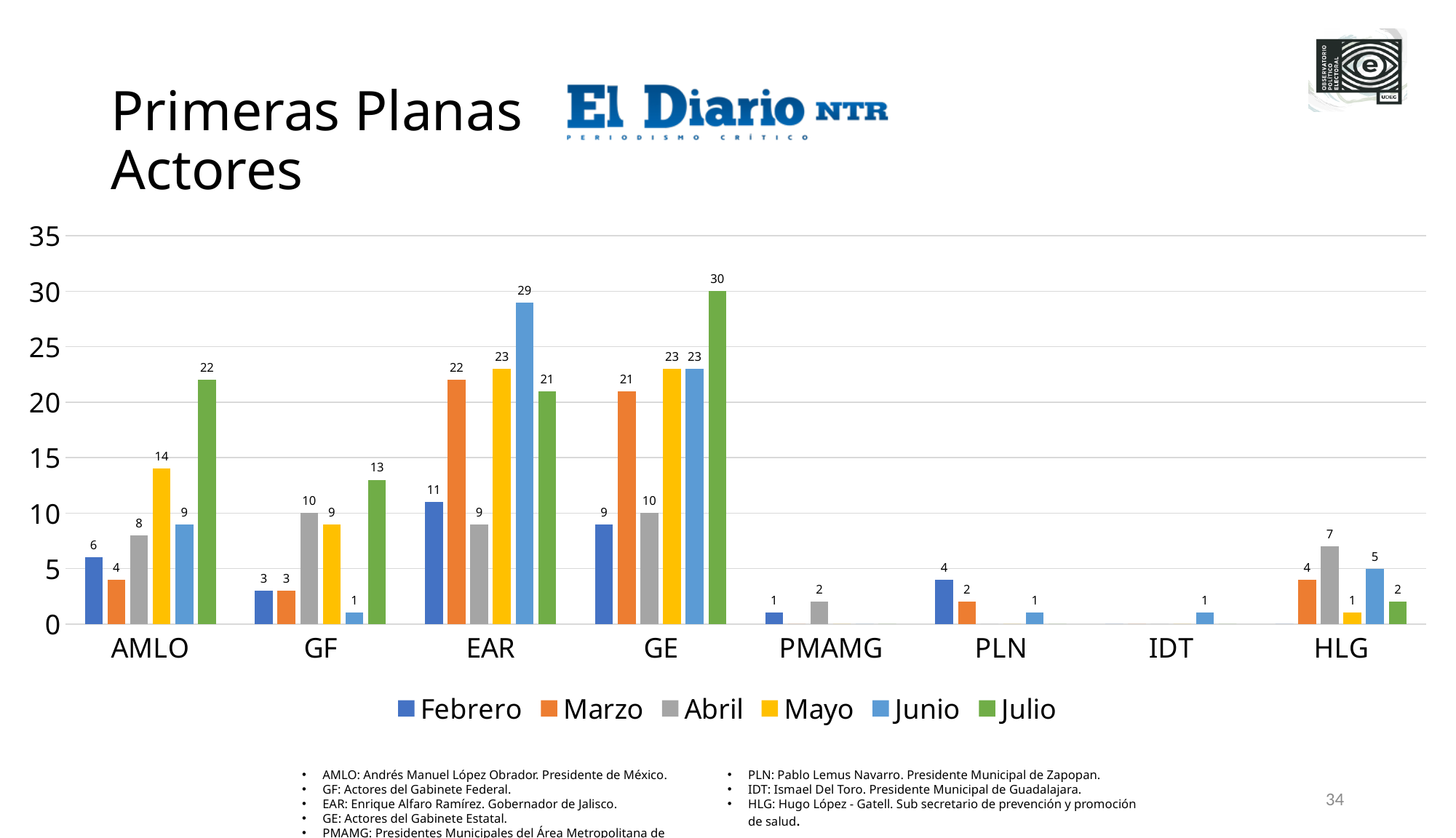
What is the value for Junio for EAR? 29 How many categories are shown on the x axis? 8 What is the value for Abril for HLG? 7 Which is larger for EAR: the Marzo value or the Mayo value? Mayo How many series does the legend list? 6 What kind of chart is shown on the slide? Bar chart Which month has the lowest value for GF? Junio What is the value for Mayo for AMLO? 14 Which category has the highest Julio value? GE What is the difference between the Julio and Febrero values for AMLO? 16 Which colour represents Mayo in the legend? Yellow What is the value for Julio for GE? 30